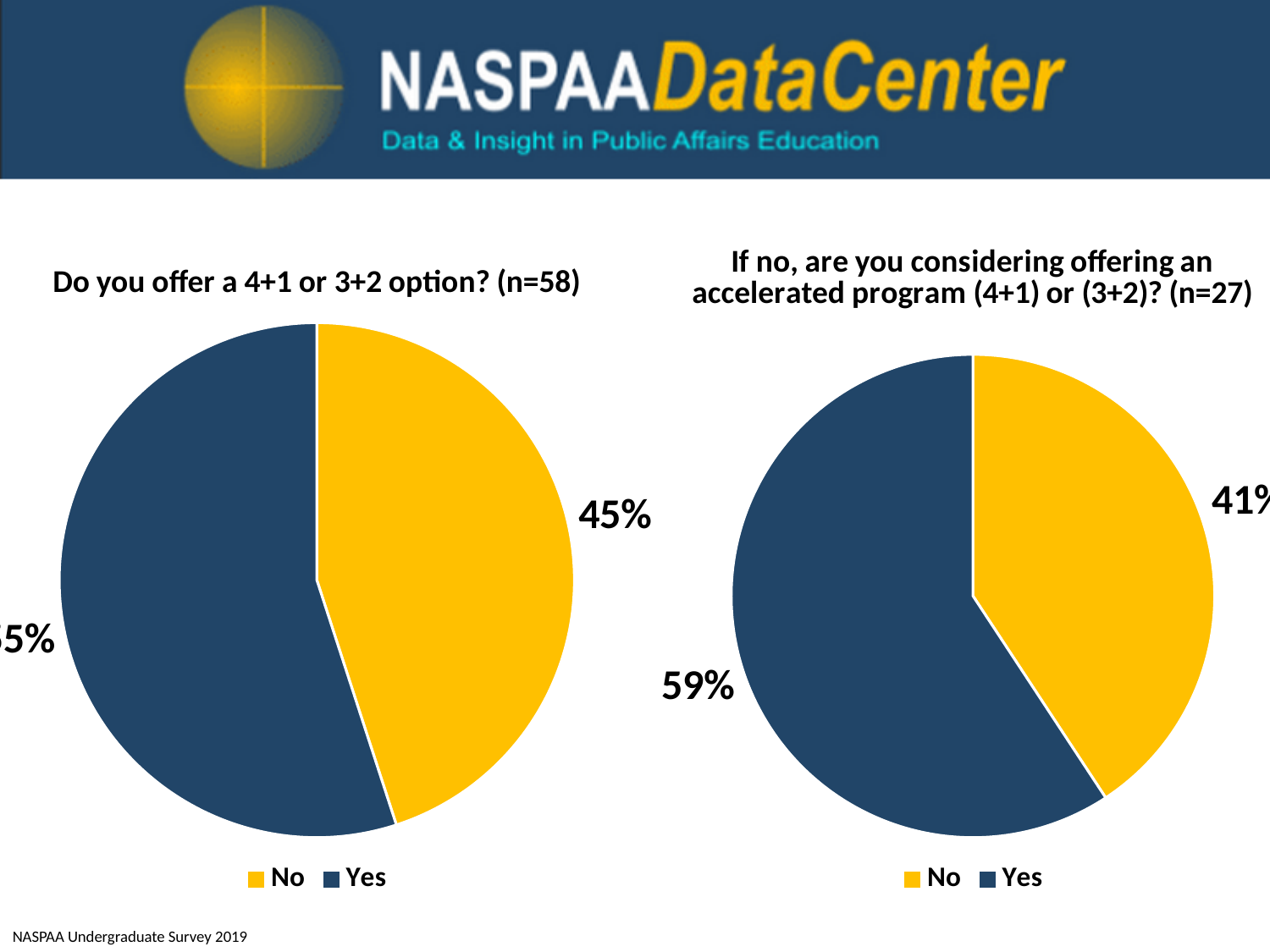
What kind of chart is the left chart titled "Do you offer a 4+1 or 3+2 option? (n=58)"? Pie chart In the right chart "If no, are you considering offering an accelerated program (4+1) or (3+2)? (n=27)", which slice is the largest? Yes In the left chart "Do you offer a 4+1 or 3+2 option? (n=58)", what colour is the "No" slice? Yellow In the right chart "If no, are you considering offering an accelerated program (4+1) or (3+2)? (n=27)", what share of the pie is "Yes"? 59% Which chart has the larger "No" share, the left chart "Do you offer a 4+1 or 3+2 option? (n=58)" or the right chart "If no, are you considering offering an accelerated program (4+1) or (3+2)? (n=27)"? The left chart In the right chart "If no, are you considering offering an accelerated program (4+1) or (3+2)? (n=27)", what share of the pie is "No"? 41% How many entries does the legend of the left chart "Do you offer a 4+1 or 3+2 option? (n=58)" list? 2 How many slices does the left chart "Do you offer a 4+1 or 3+2 option? (n=58)" have? 2 What are the legend entries of the right chart "If no, are you considering offering an accelerated program (4+1) or (3+2)? (n=27)"? No, Yes In the left chart "Do you offer a 4+1 or 3+2 option? (n=58)", what share of the pie is "No"? 45% In the left chart "Do you offer a 4+1 or 3+2 option? (n=58)", which slice is larger, "No" or "Yes"? Yes In the right chart "If no, are you considering offering an accelerated program (4+1) or (3+2)? (n=27)", how many percentage points larger is "Yes" than "No"? 18 percentage points